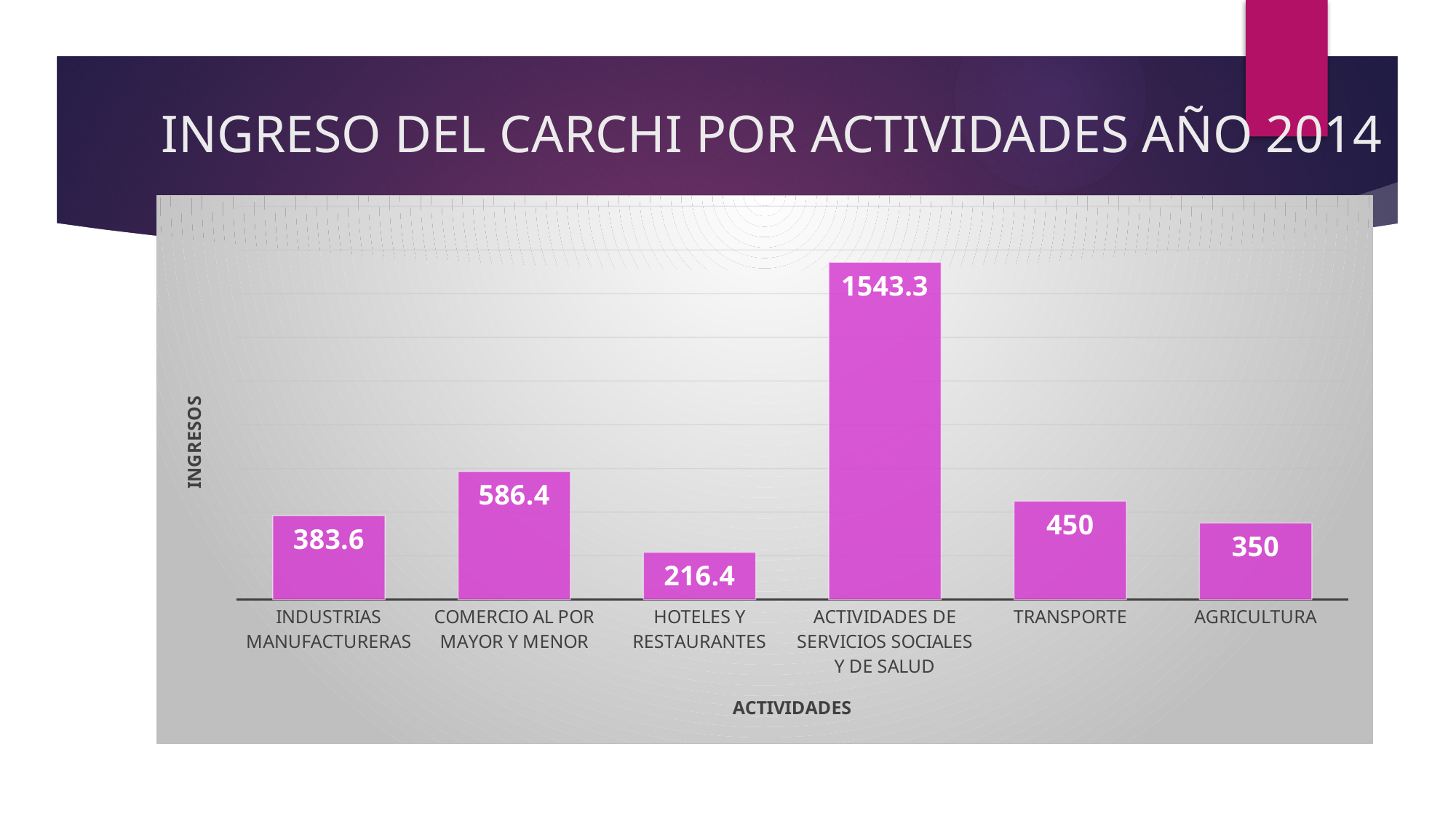
What kind of chart is shown on the slide? bar chart Which is larger, the value for TRANSPORTE or the value for AGRICULTURA? TRANSPORTE How many activities are shown on the x axis? 6 What is the value for COMERCIO AL POR MAYOR Y MENOR? 586.4 Which activity has the highest value? ACTIVIDADES DE SERVICIOS SOCIALES Y DE SALUD What is the value for TRANSPORTE? 450 What is the title of the slide? INGRESO DEL CARCHI POR ACTIVIDADES AÑO 2014 Which activity has the lowest value? HOTELES Y RESTAURANTES What is the value for INDUSTRIAS MANUFACTURERAS? 383.6 What is the value for HOTELES Y RESTAURANTES? 216.4 What is the difference between the values for COMERCIO AL POR MAYOR Y MENOR and INDUSTRIAS MANUFACTURERAS? 202.8 What is the difference between the values for TRANSPORTE and AGRICULTURA? 100